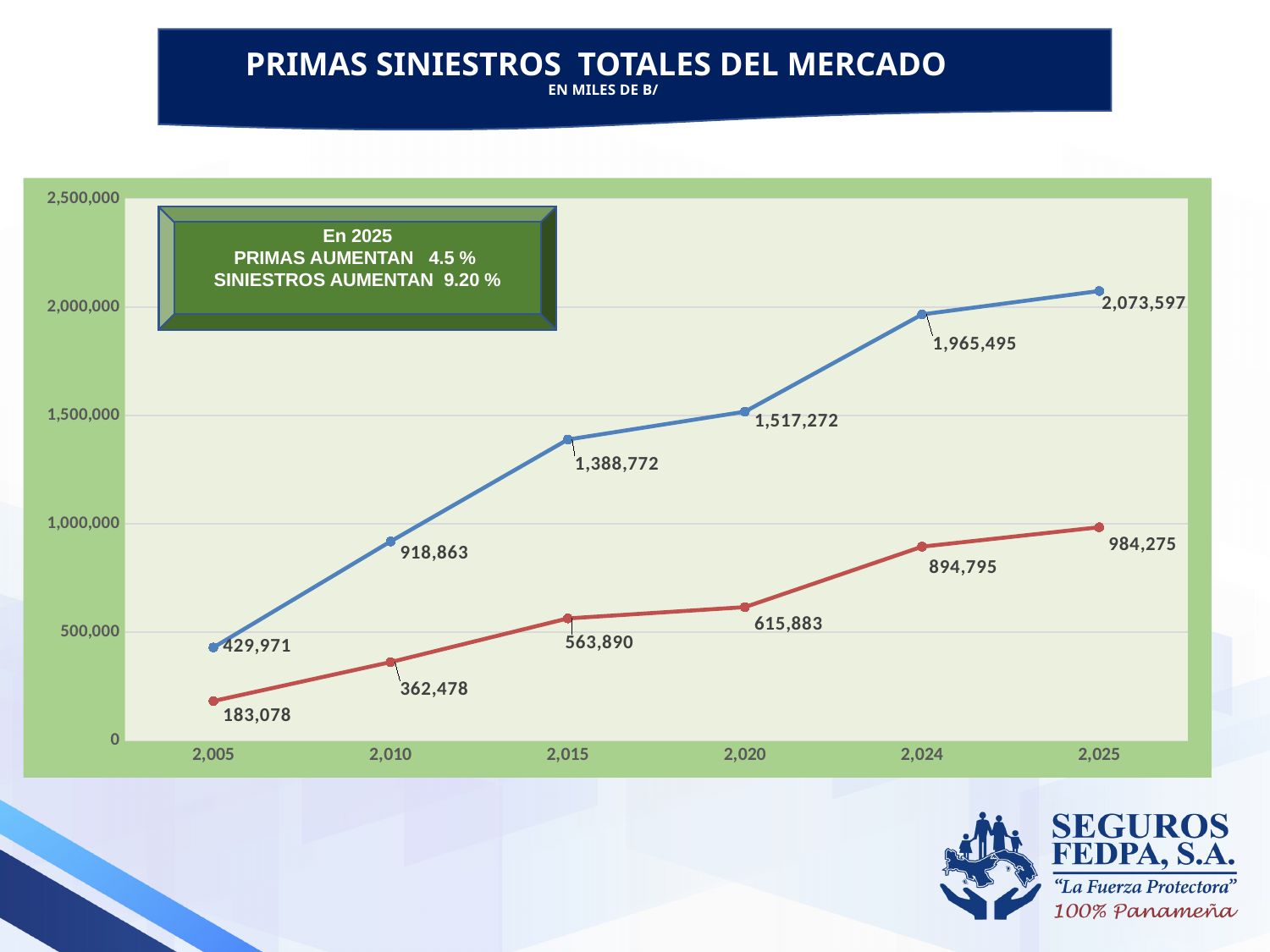
How many years are plotted on the x axis? 6 Which is larger: the blue line at 2,015 or the red line at 2,024? The blue line at 2,015 What is the value of the red line at 2,005? 183,078 By how much does the blue line increase from 2,020 to 2,024? 448,223 What is the difference between the blue line and the red line at 2,025? 1,089,322 Do the values of the red line rise or fall from 2,005 to 2,025? Rise What kind of chart is shown on the slide? Line chart In which year does the red line have its lowest value? 2,005 Is the value of the red line at 2,020 greater or less than 1,000,000? less In which year does the blue line reach its highest value? 2,025 What is the value of the blue line at 2,025? 2,073,597 What is the value of the blue line at 2,015? 1,388,772